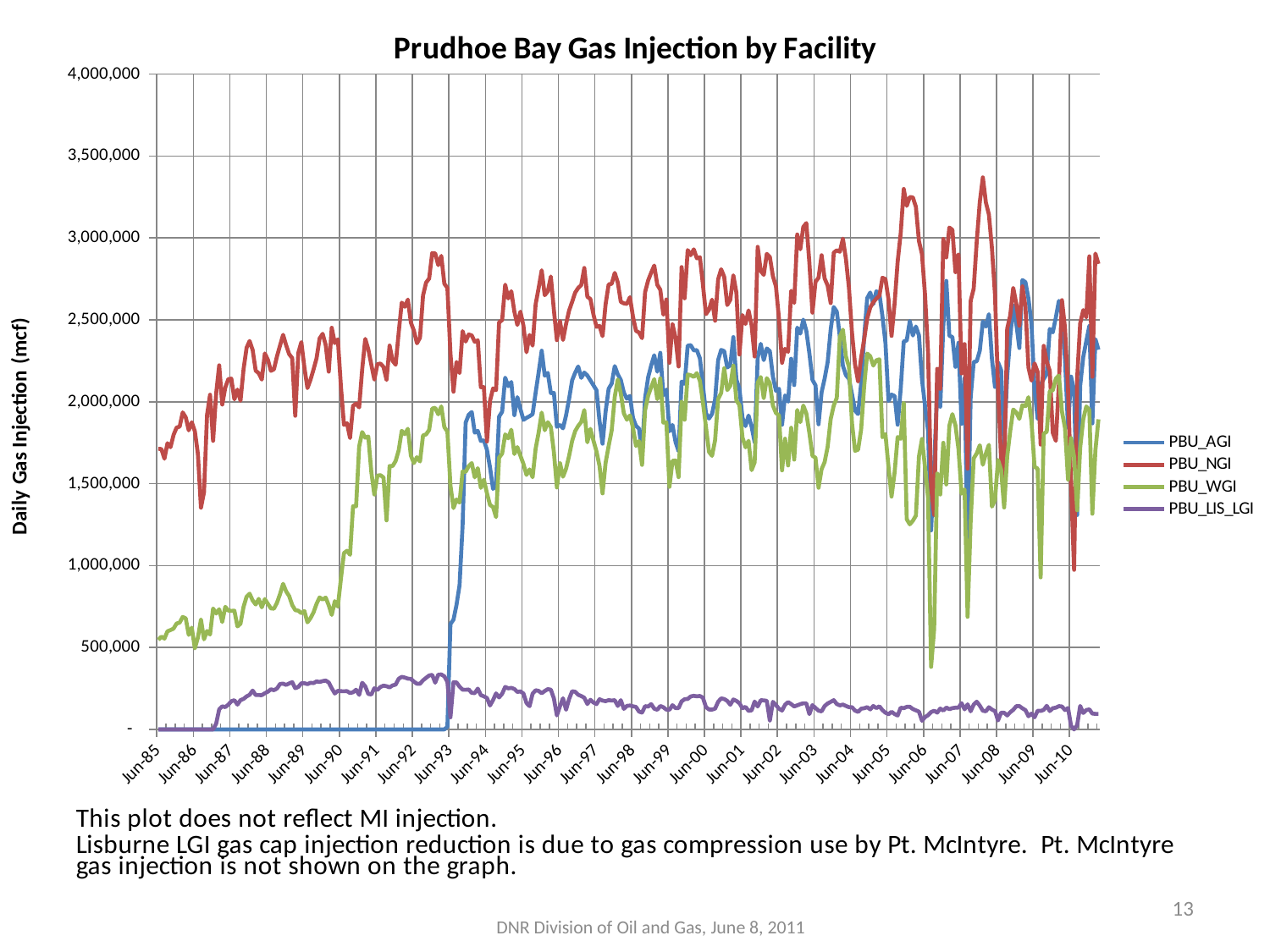
Which series has the lowest values across the chart? PBU_LIS_LGI How many series does the legend list? 4 Is the value for PBU_AGI at Jun-85 greater or less than 500,000? less What is the label on the vertical axis? Daily Gas Injection (mcf) Does the PBU_AGI series rise or fall between Jun-93 and Jun-94? rise Is the value for PBU_WGI at Jun-85 greater or less than 1,000,000? less How many date labels are shown on the x axis? 26 Which series has the highest values across most of the chart? PBU_NGI What kind of chart is shown on the slide? line chart At Jun-85, which series is larger, PBU_NGI or PBU_WGI? PBU_NGI What is the title of the chart? Prudhoe Bay Gas Injection by Facility Is the value for PBU_NGI at Jun-85 greater or less than 1,500,000? greater